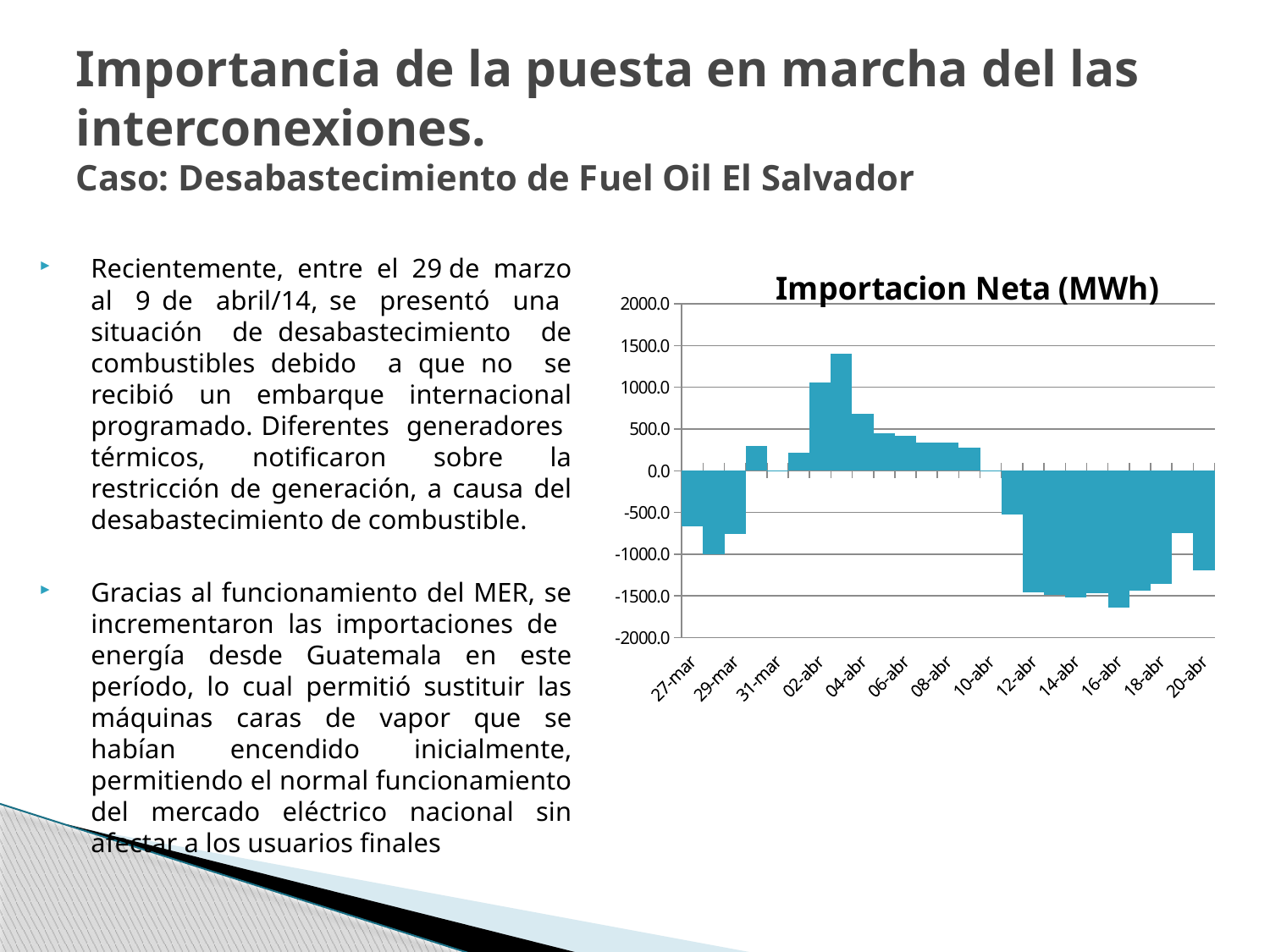
Is the value for 27-mar greater or less than 0.0? less Is the value for 14-abr greater or less than -1000.0? less Is the value for 06-abr greater or less than 0.0? greater What is the highest value shown on the chart's vertical axis? 2000.0 Which has the larger value, 27-mar or 14-abr? 27-mar How many date labels are shown on the chart's horizontal axis? 13 Around which labeled date does the chart reach its lowest value? 16-abr Between 04-abr and 10-abr, do the values rise or fall? fall What is the title of the chart on the slide? Importacion Neta (MWh)